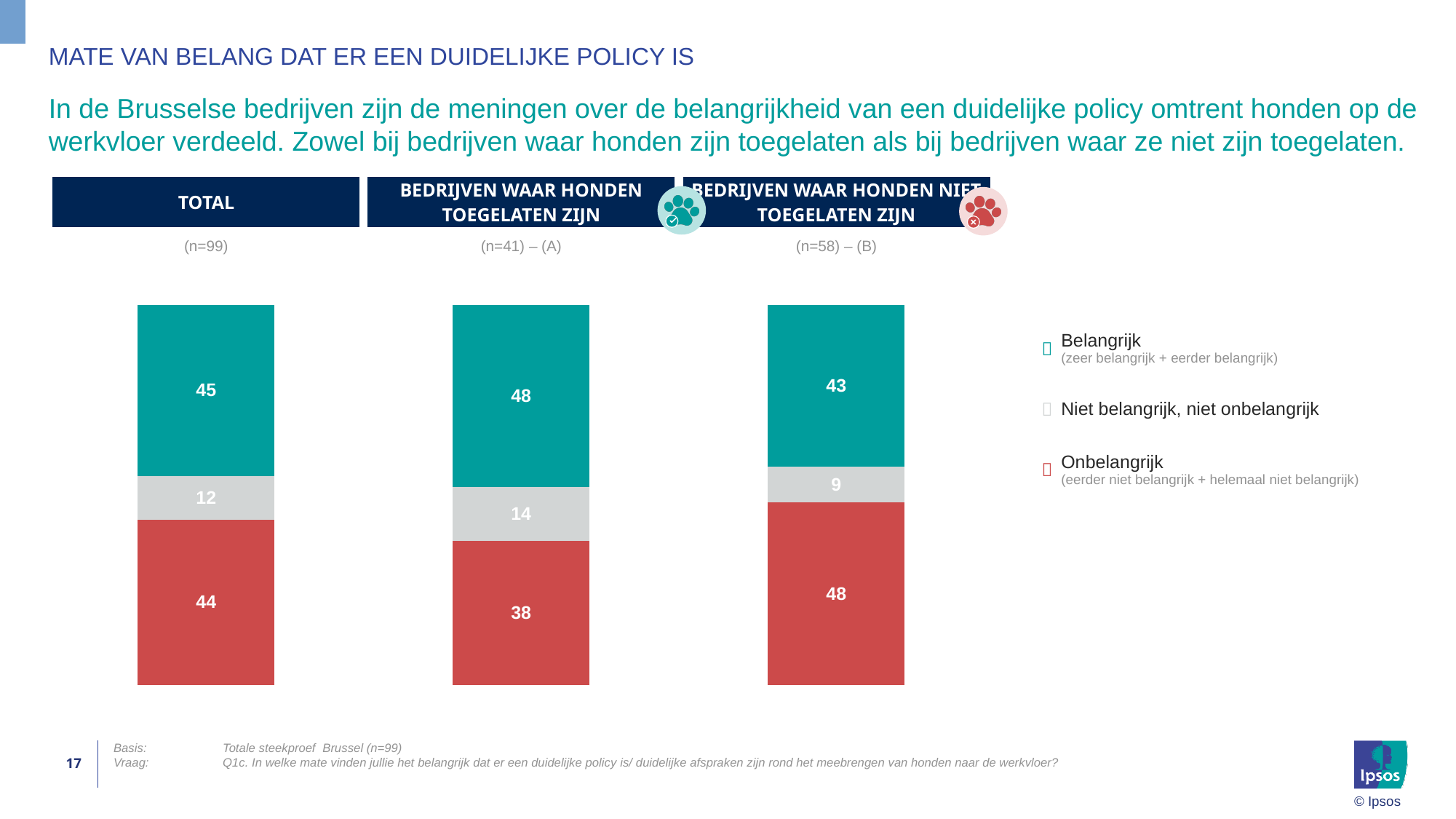
Which of the three bars has the highest value for Onbelangrijk? Bedrijven waar honden niet toegelaten zijn What is the value for Onbelangrijk in the bar for bedrijven waar honden toegelaten zijn? 38 What kind of chart is shown on the slide? Stacked bar chart What is the value for Belangrijk in the bar for bedrijven waar honden niet toegelaten zijn? 43 What is the total of the stacked bar for bedrijven waar honden toegelaten zijn? 100 How many series does the legend list? 3 What is the difference between the Belangrijk values for bedrijven waar honden toegelaten zijn and bedrijven waar honden niet toegelaten zijn? 5 Which of the three bars has the lowest value for Niet belangrijk, niet onbelangrijk? Bedrijven waar honden niet toegelaten zijn What is the value for Belangrijk in the TOTAL bar? 45 How many stacked bars are shown on the slide? 3 What is the value for Niet belangrijk, niet onbelangrijk in the bar for bedrijven waar honden niet toegelaten zijn? 9 Is the Onbelangrijk value larger for bedrijven waar honden toegelaten zijn or for bedrijven waar honden niet toegelaten zijn? Bedrijven waar honden niet toegelaten zijn